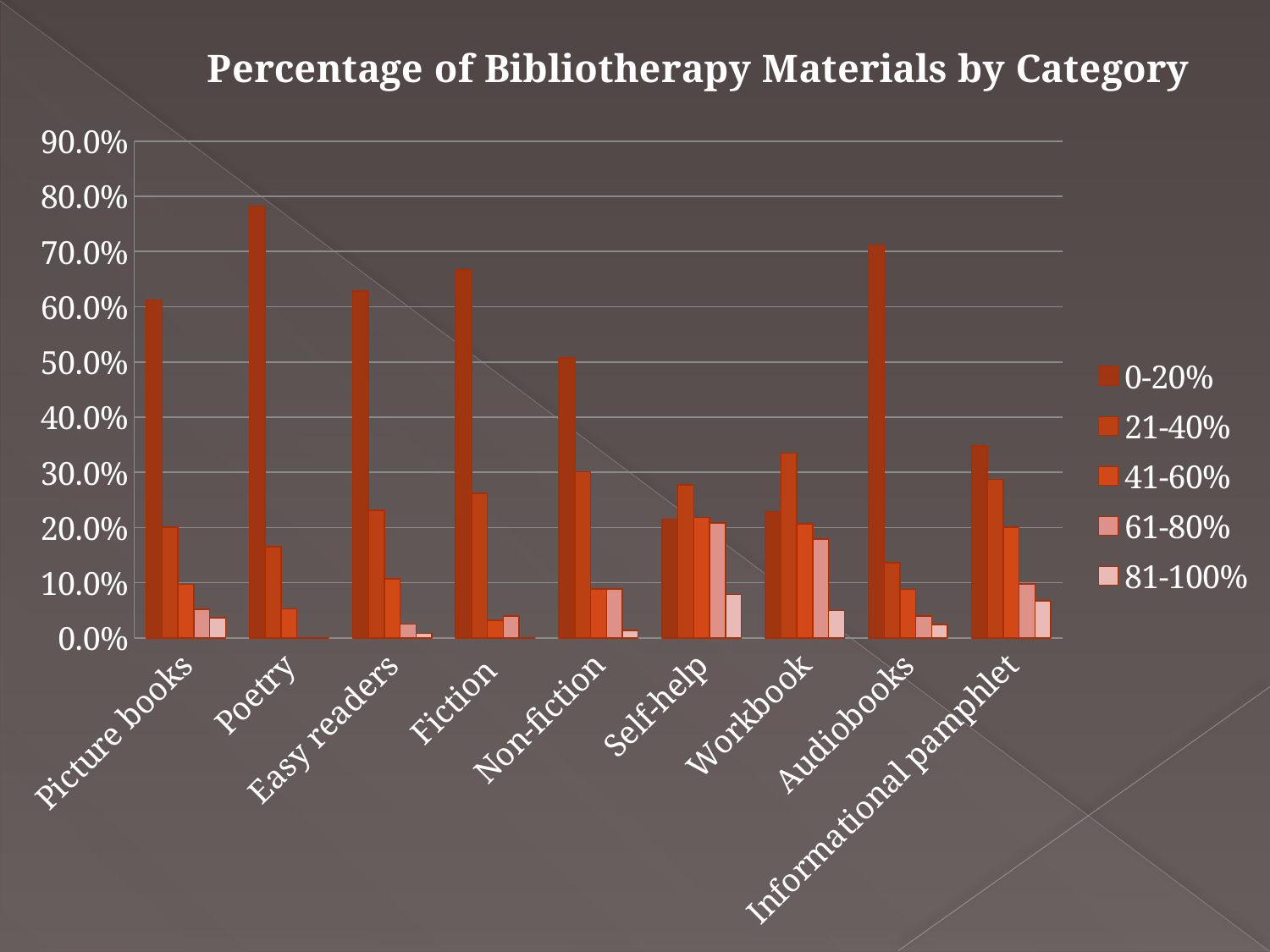
Is the 0-20% value for Informational pamphlet greater or less than 40.0%? less Which category has the highest value for the 81-100% series? Self-help Which category has the highest value for the 0-20% series? Poetry What is the title of the chart? Percentage of Bibliotherapy Materials by Category Is the 0-20% value for Audiobooks greater or less than 60.0%? greater Is the 0-20% value for Poetry greater or less than 70.0%? greater How many series does the legend list? 5 How many categories are shown on the x axis? 9 What type of chart is shown on the slide? bar chart Which is larger for the 0-20% series: Picture books or Fiction? Fiction Which is larger for the 21-40% series: Poetry or Easy readers? Easy readers